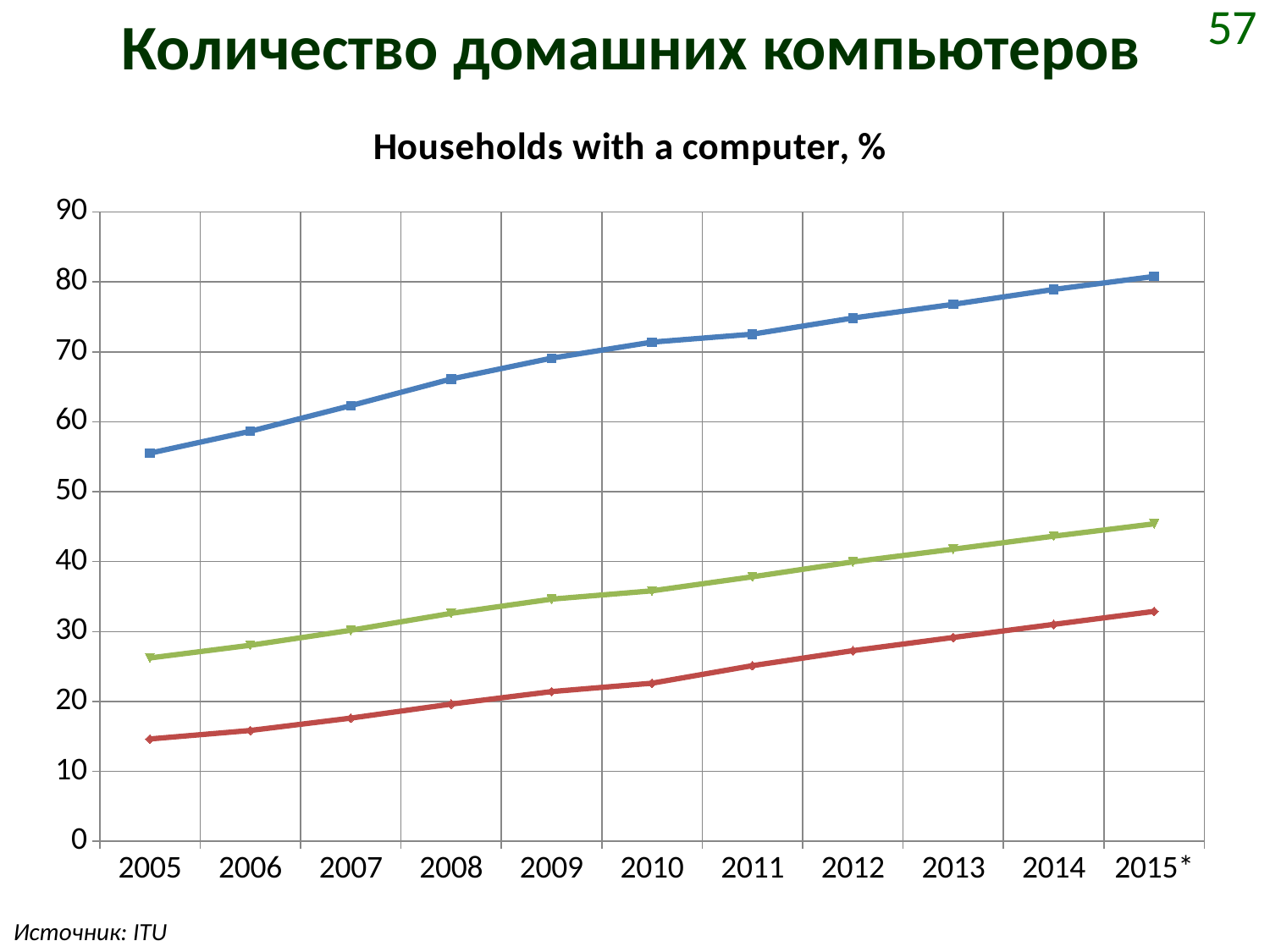
Is the value of the green line in 2005 greater or less than 30? less How many lines are plotted on the chart? 3 What is the title of the chart? Households with a computer, % Is the value of the blue line in 2005 greater or less than 50? greater What kind of chart is shown on the slide? line chart Which line has the highest values throughout the chart? the blue line Does the blue line rise or fall from 2005 to 2015*? rise Is the value of the green line in 2015* greater or less than 40? greater Which line has the lowest values throughout the chart? the red line In 2010, which is larger: the value of the blue line or the value of the green line? the blue line How many years are plotted along the x axis? 11